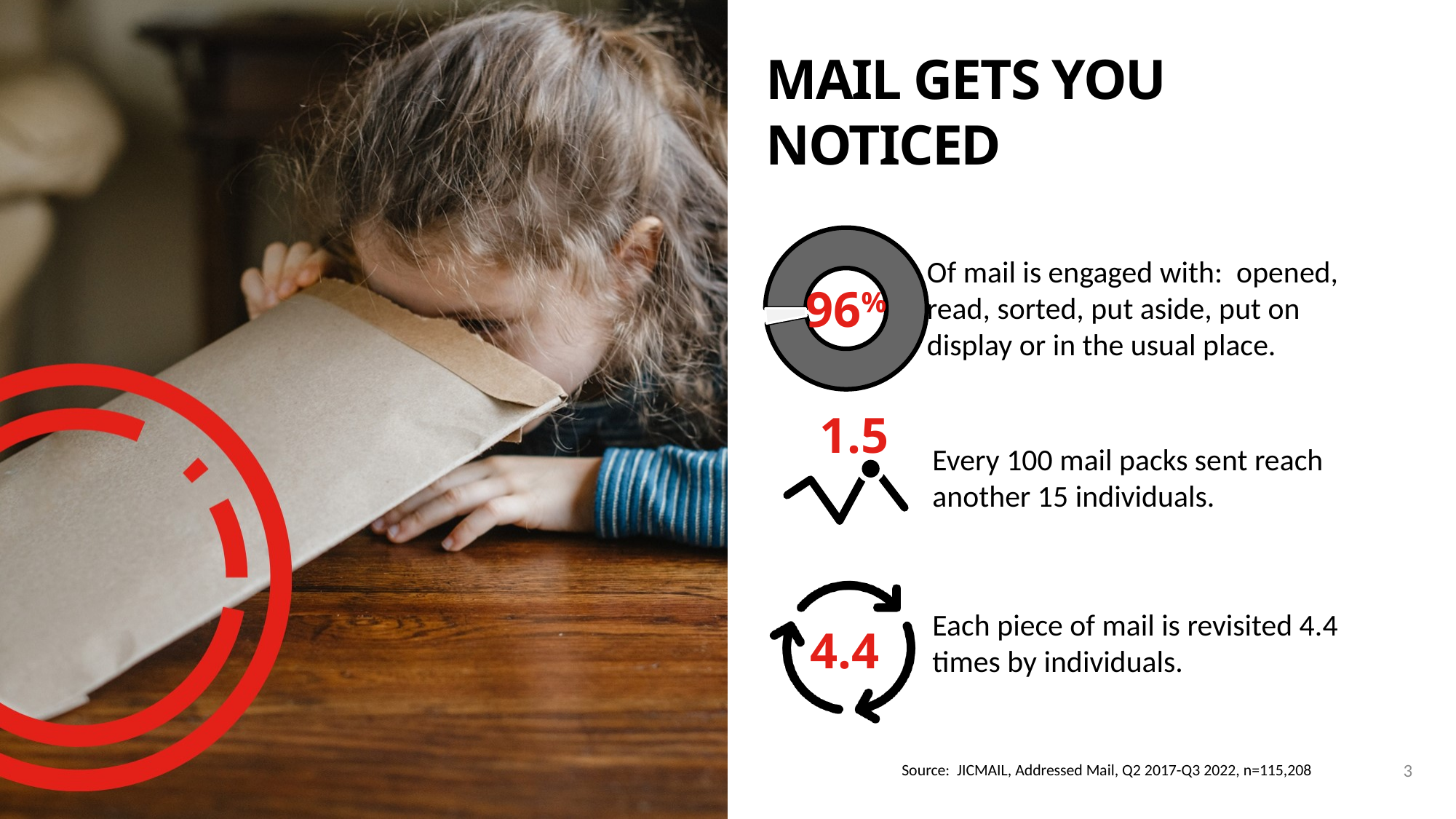
What kind of chart is shown next to the text 'Of mail is engaged with'? Pie (donut) chart Which segment of the donut chart is larger, the grey one or the white one? The grey one According to the slide, what does the 96% in the donut chart represent? Mail that is engaged with (opened, read, sorted, put aside, put on display or in the usual place) What colour is the large segment of the donut chart? Grey How many segments does the donut chart have? 2 What percentage is printed in the centre of the donut chart? 96% Is the grey segment of the donut chart greater or less than 50% of the whole? greater